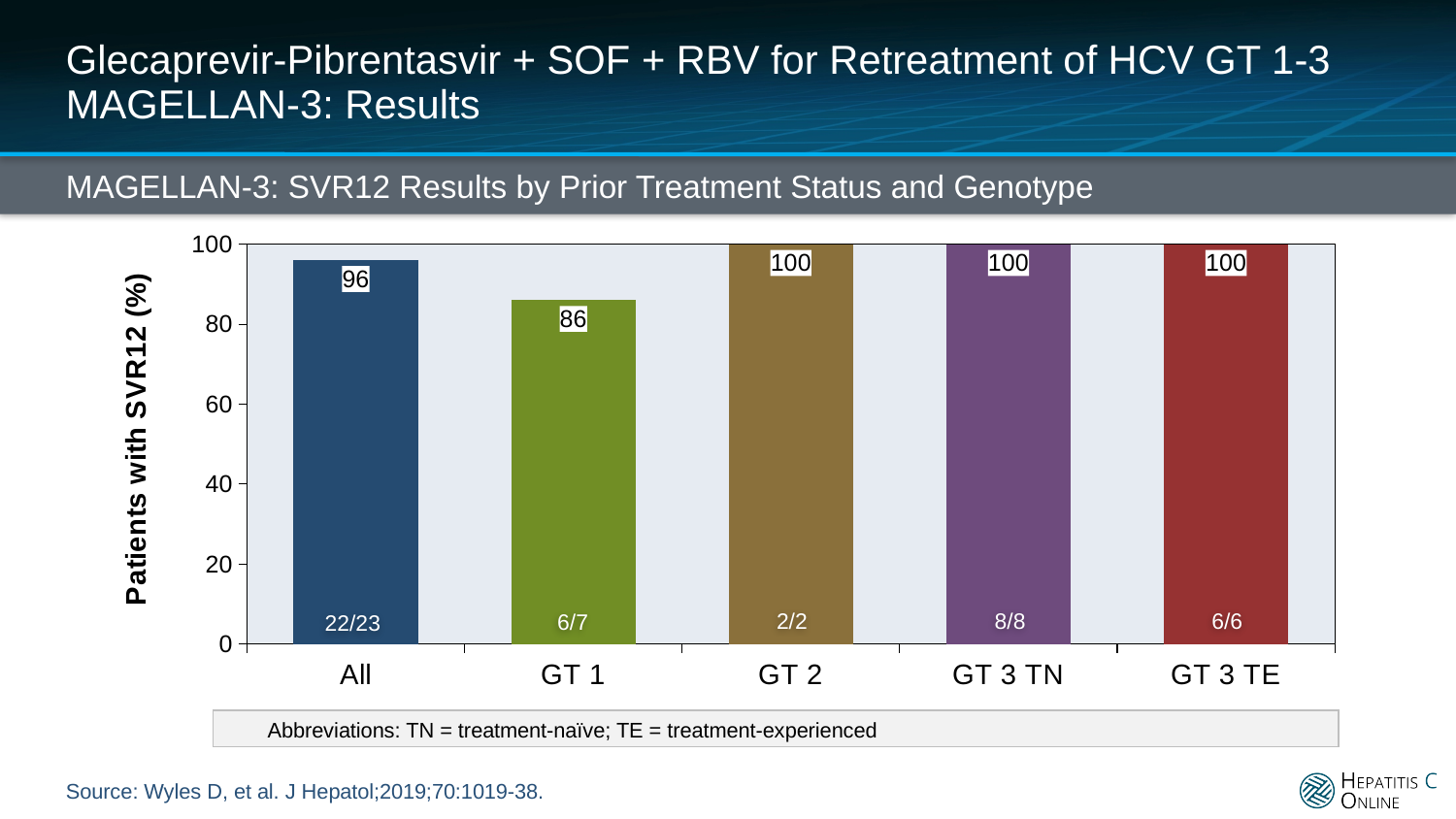
What is the difference in SVR12 rate between GT 2 and GT 1? 14 Is the SVR12 rate for GT 1 greater or less than 80? greater What kind of chart is shown on the slide? Bar chart What is the label of the y axis? Patients with SVR12 (%) What is the SVR12 rate for GT 1? 86 Which category has the lowest SVR12 rate? GT 1 What is the SVR12 rate for the All group? 96 How many categories are shown on the x axis? 5 What fraction of patients is shown inside the All bar? 22/23 What is the SVR12 rate for GT 3 TN? 100 Which has a higher SVR12 rate, All or GT 1? All What fraction of patients is shown inside the GT 1 bar? 6/7